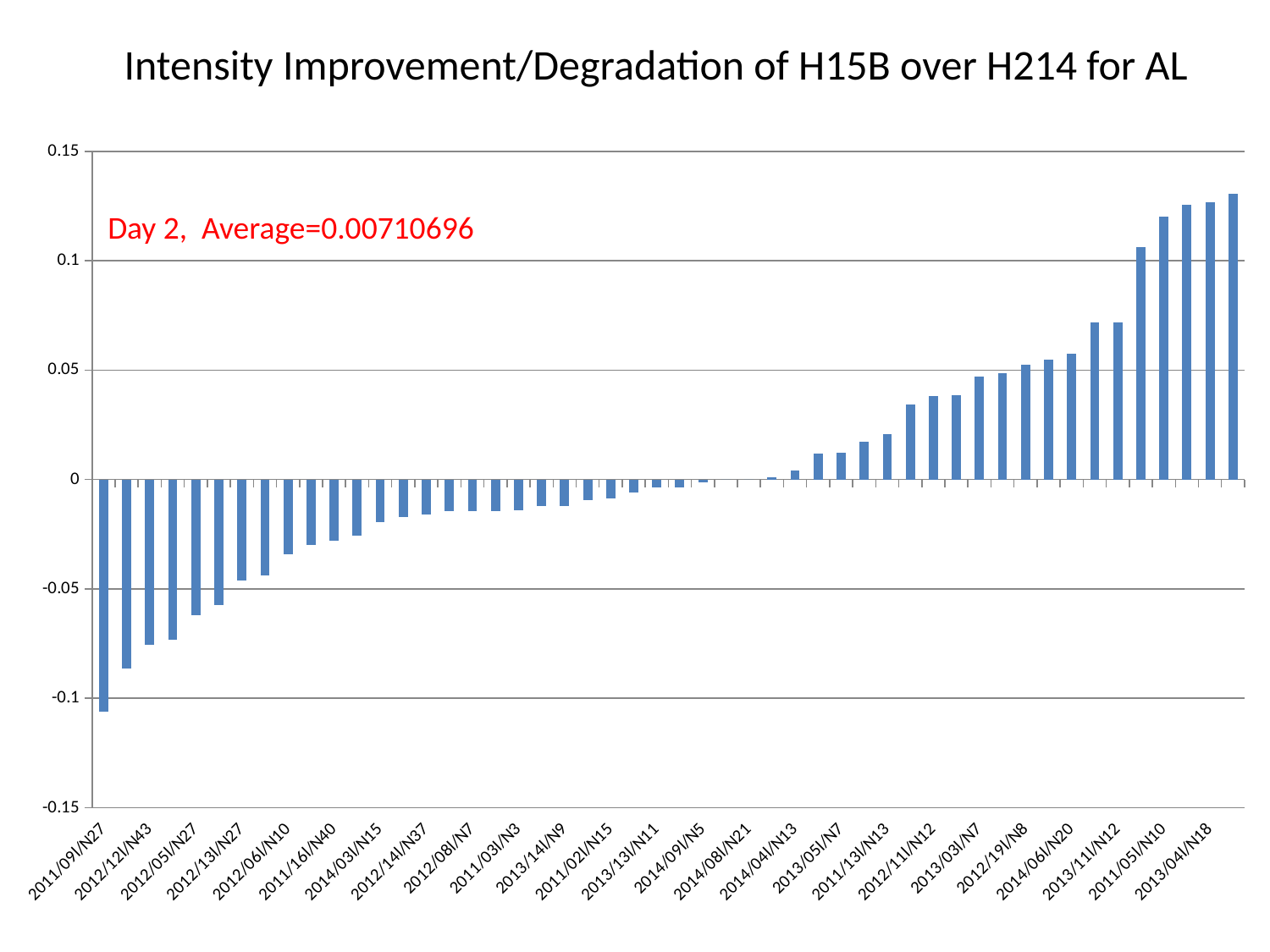
Is the value for 2013/04/N18 greater or less than 0.1? greater What is the title of the chart? Intensity Improvement/Degradation of H15B over H214 for AL Is the value for 2012/12/N43 greater or less than -0.05? less Which category has the lowest value? 2011/09l/N27 Is the value for 2014/06/N20 greater or less than 0.05? greater What kind of chart is shown on the slide? bar chart What average value is printed in red on the chart? 0.00710696 Which has the larger value, 2012/12/N43 or 2012/06/N10? 2012/06l/N10 Do the bar values rise or fall from left to right along the x axis? rise